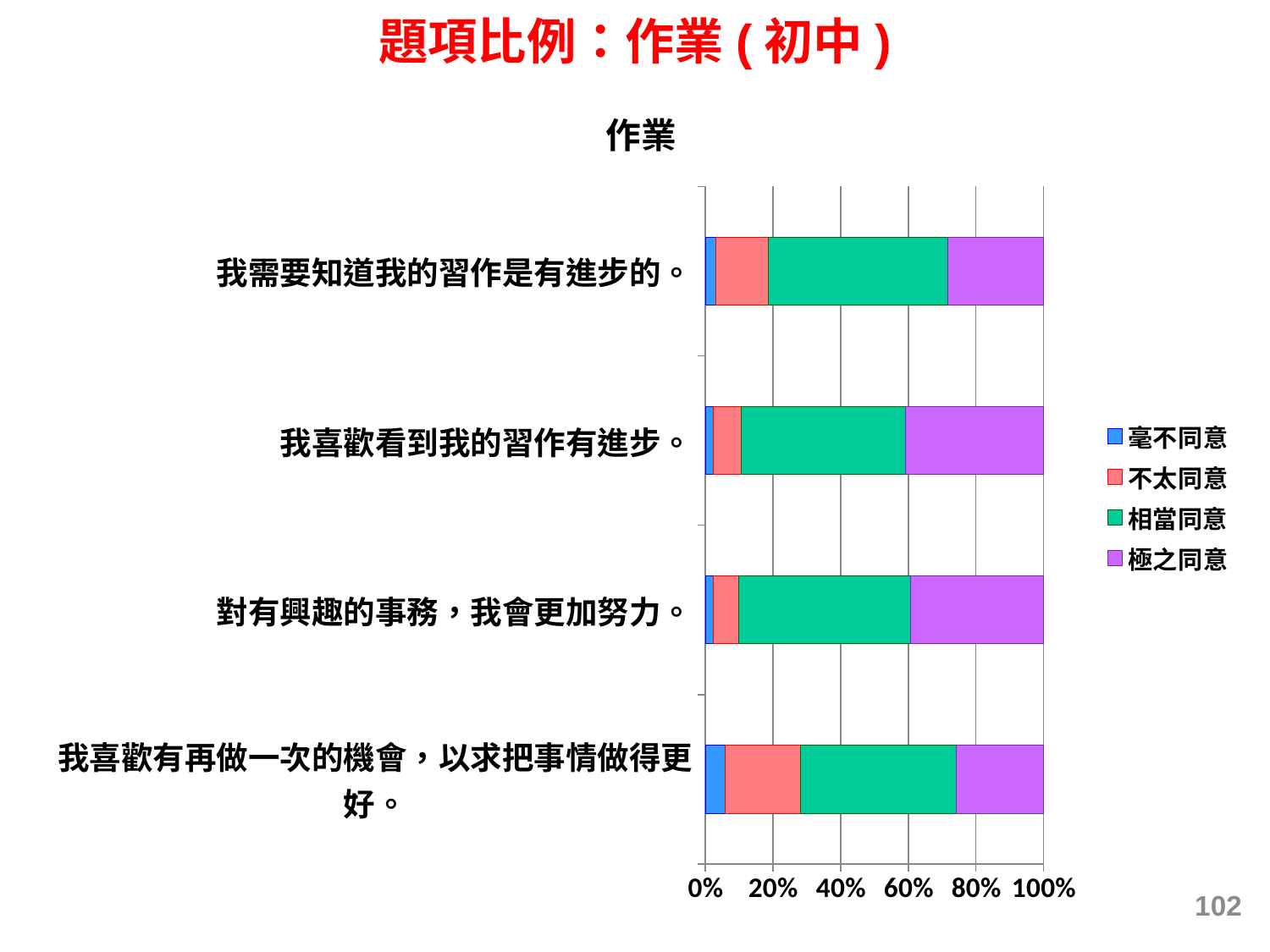
Which has the larger 毫不同意 share: "我喜歡有再做一次的機會，以求把事情做得更好。" or "我喜歡看到我的習作有進步。"? 我喜歡有再做一次的機會，以求把事情做得更好。 Which legend entry is shown in green? 相當同意 How many statements (categories) are plotted in the chart? 4 What kind of chart is shown on the slide? Stacked bar chart Which has the larger 不太同意 share: "我喜歡有再做一次的機會，以求把事情做得更好。" or "對有興趣的事務，我會更加努力。"? 我喜歡有再做一次的機會，以求把事情做得更好。 How many series does the legend list? 4 Which statement has the largest 不太同意 segment? 我喜歡有再做一次的機會，以求把事情做得更好。 Is the 不太同意 share for "對有興趣的事務，我會更加努力。" greater or less than 20%? less Is the 極之同意 share for "我需要知道我的習作是有進步的。" greater or less than 20%? greater Is the 毫不同意 share for "我喜歡看到我的習作有進步。" greater or less than 20%? less What is the title of the chart? 作業